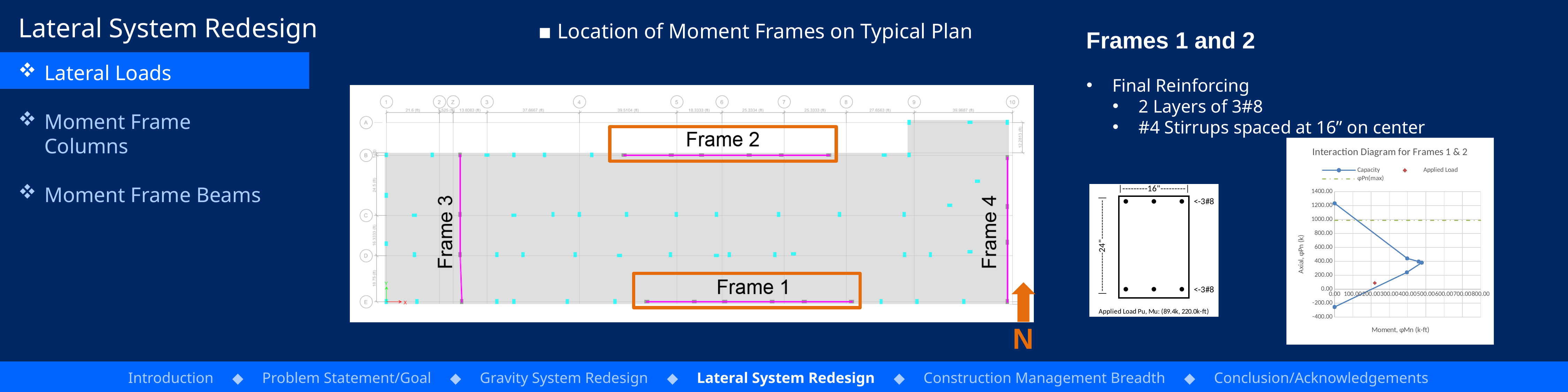
In the Interaction Diagram for Frames 1 & 2, is the axial value of the topmost Capacity point (at zero moment) greater or less than 1000.00? greater How many data points are plotted on the Capacity curve in the Interaction Diagram for Frames 1 & 2? 6 In the Interaction Diagram for Frames 1 & 2, is the φPn(max) line greater or less than 800.00 on the axial axis? greater In the Interaction Diagram for Frames 1 & 2, is the Applied Load point's axial value larger or smaller than the φPn(max) line? smaller In the Interaction Diagram for Frames 1 & 2, how many series does the legend list? 3 What kind of chart is the Interaction Diagram for Frames 1 & 2? line chart What is the title of the chart on the right side of the slide? Interaction Diagram for Frames 1 & 2 In the Interaction Diagram for Frames 1 & 2, which series reaches the highest axial value? Capacity In the Interaction Diagram for Frames 1 & 2, is the moment value of the Applied Load point greater or less than 300.00? less What is the label of the horizontal axis of the Interaction Diagram for Frames 1 & 2? Moment, φMn (k-ft)